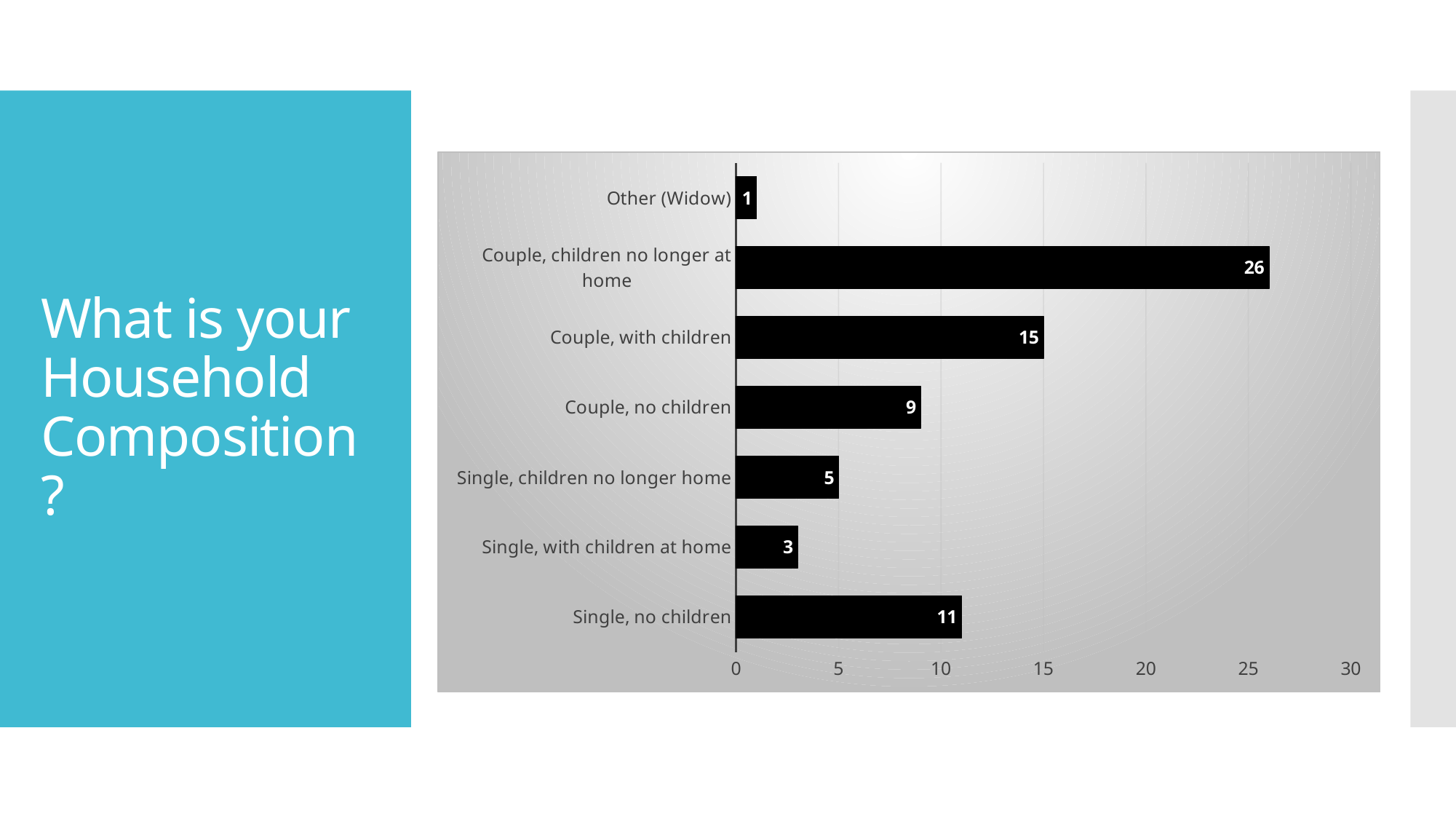
What is the value for "Single, no children"? 11 Which category has the highest value? Couple, children no longer at home Is the value for "Couple, with children" greater or less than 10? greater What is the difference between "Couple, with children" and "Couple, no children"? 6 What is the value for "Single, with children at home"? 3 Which category has the lowest value? Other (Widow) What kind of chart is shown on the slide? bar chart What is the highest value shown on the horizontal axis? 30 Which is larger: "Single, no children" or "Couple, no children"? Single, no children What is the value for "Couple, children no longer at home"? 26 What is the value for "Single, children no longer home"? 5 How many categories are shown in the chart? 7